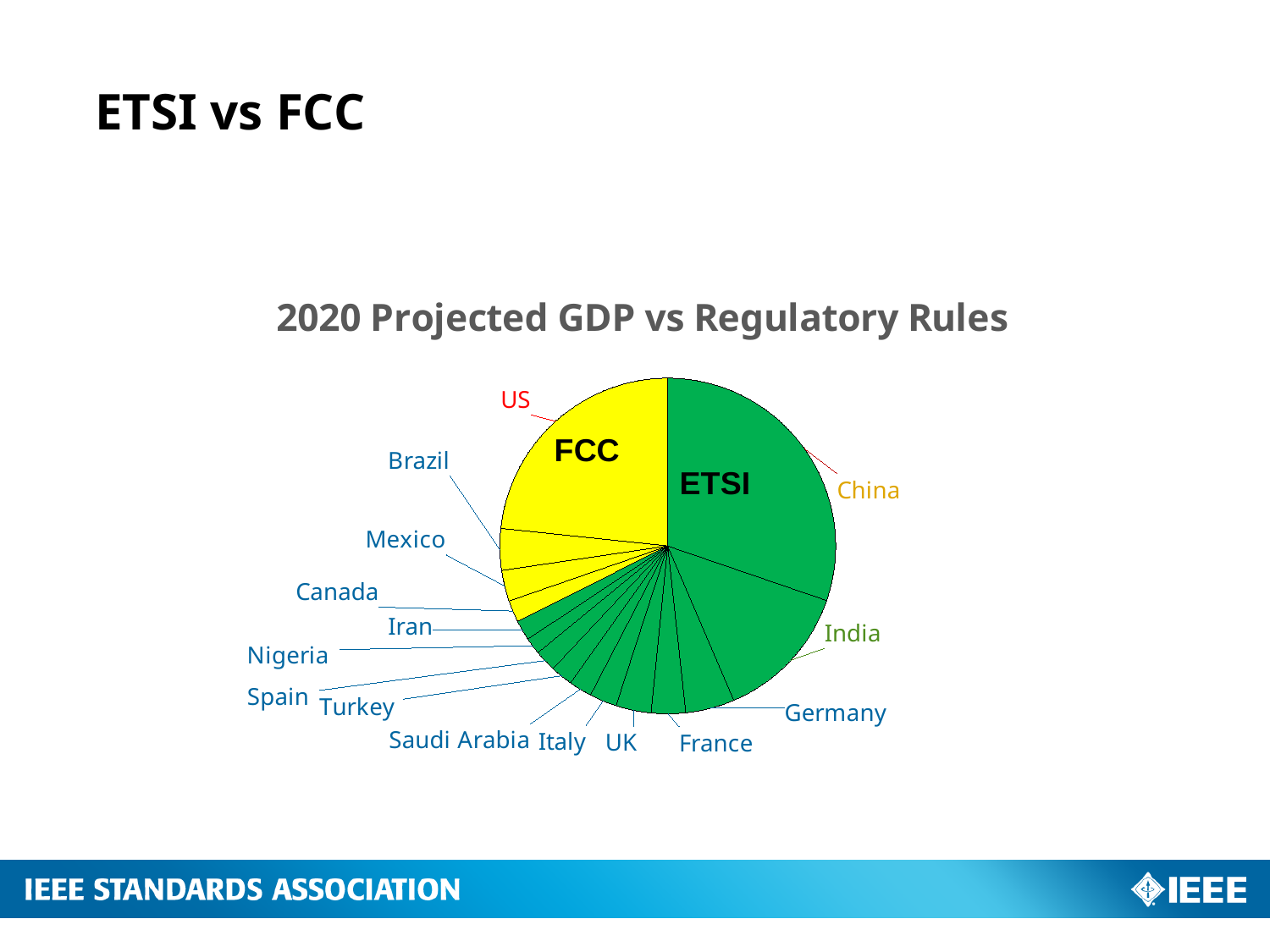
What kind of chart is shown on the slide? pie chart Which colour is used for the FCC group of slices? yellow Which slice is larger, US or Mexico? US What is the title of the chart? 2020 Projected GDP vs Regulatory Rules Which slice is larger, India or Germany? India Which slice is larger, Germany or Nigeria? Germany How many countries are labelled as slices in the pie chart? 15